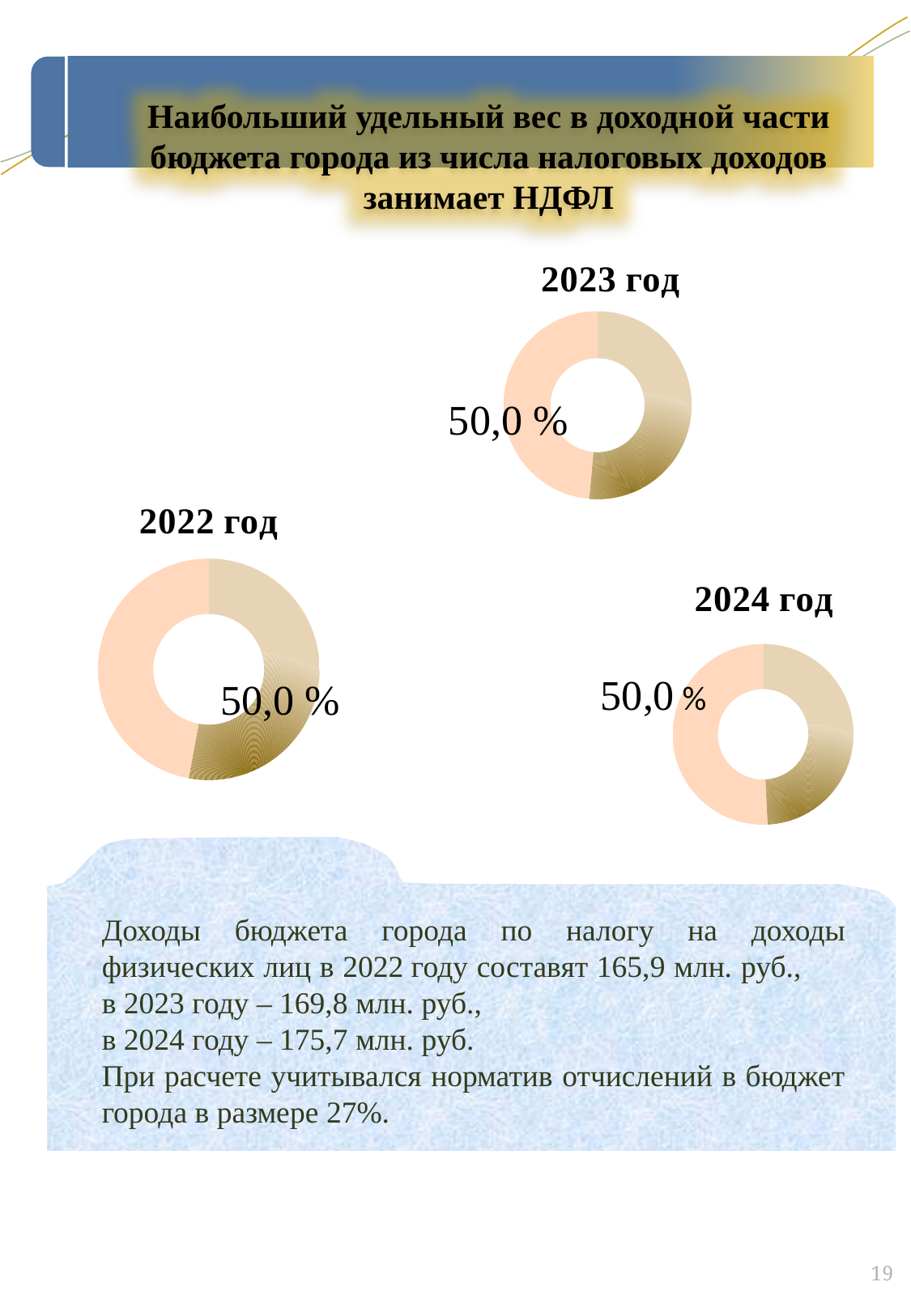
How many doughnut charts are shown on the slide? 3 What kind of chart is the one titled "2022 год"? doughnut chart What is the title of the chart positioned at the bottom right of the slide? 2024 год How many slices does the chart titled "2022 год" have? 2 What is the title of the chart positioned at the top of the slide? 2023 год In the chart titled "2022 год", what percentage value is printed as a data label? 50,0 % What kind of chart is the one titled "2024 год"? doughnut chart In the chart titled "2023 год", what percentage value is printed as a data label? 50,0 % Is the labelled share in the chart titled "2022 год" greater or less than 60%? less How many slices does the chart titled "2023 год" have? 2 In the chart titled "2024 год", what percentage value is printed as a data label? 50,0 % Is the labelled share in the chart titled "2024 год" greater or less than 40%? greater